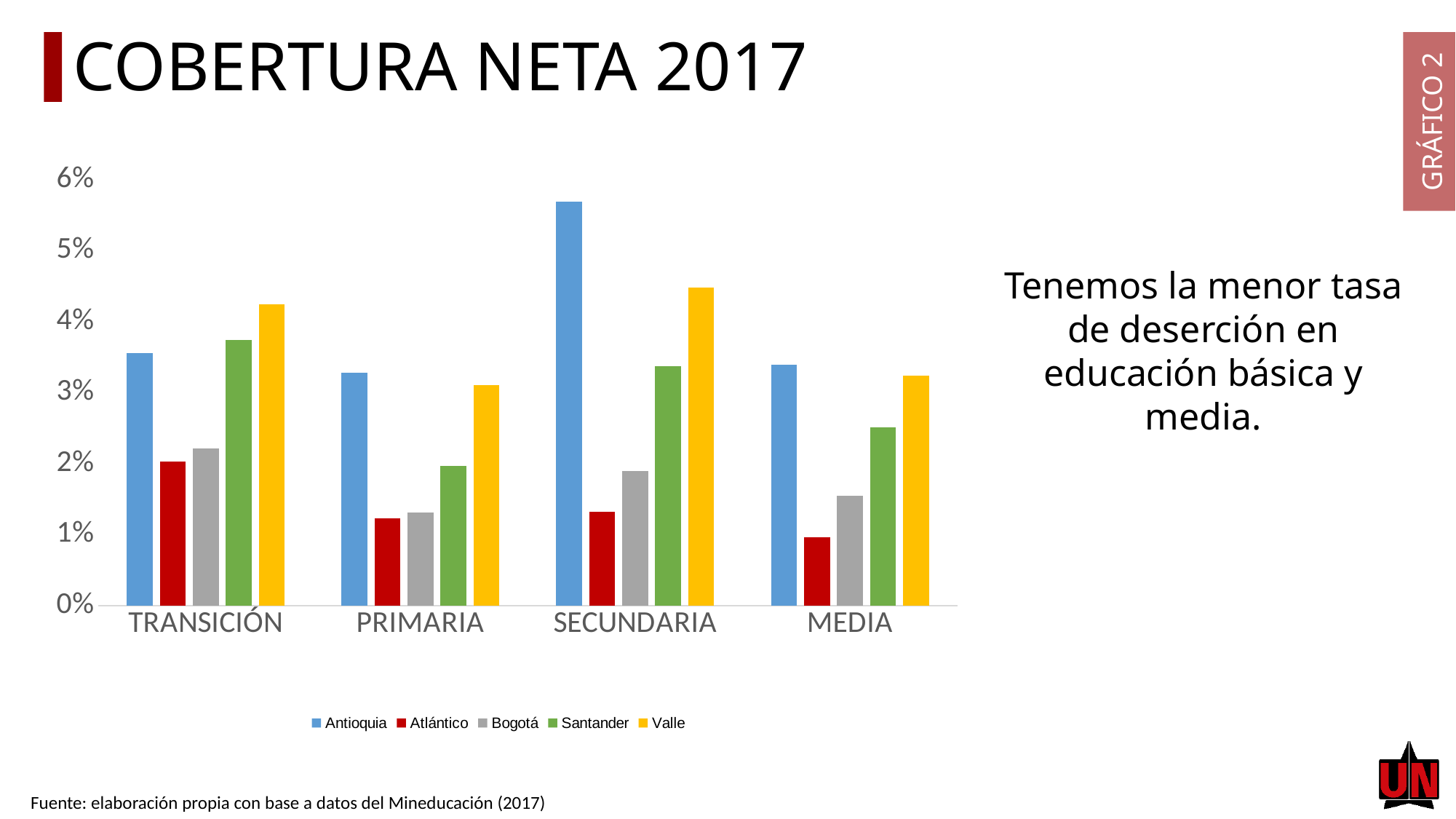
In the SECUNDARIA category, which is larger: Antioquia or Valle? Antioquia Which series has the highest bar in the SECUNDARIA category? Antioquia Is the value for Atlántico in PRIMARIA greater or less than 2%? less What is the title of the chart on the slide? COBERTURA NETA 2017 Is the value for Antioquia in SECUNDARIA greater or less than 5%? greater In which category does Antioquia have its highest bar? SECUNDARIA What kind of chart is shown on the slide? bar chart Is the value for Valle in TRANSICIÓN greater or less than 4%? greater Which series has the lowest bar in the MEDIA category? Atlántico How many series does the chart's legend list? 5 How many categories are shown on the x axis of the chart? 4 In the TRANSICIÓN category, which is larger: Valle or Santander? Valle